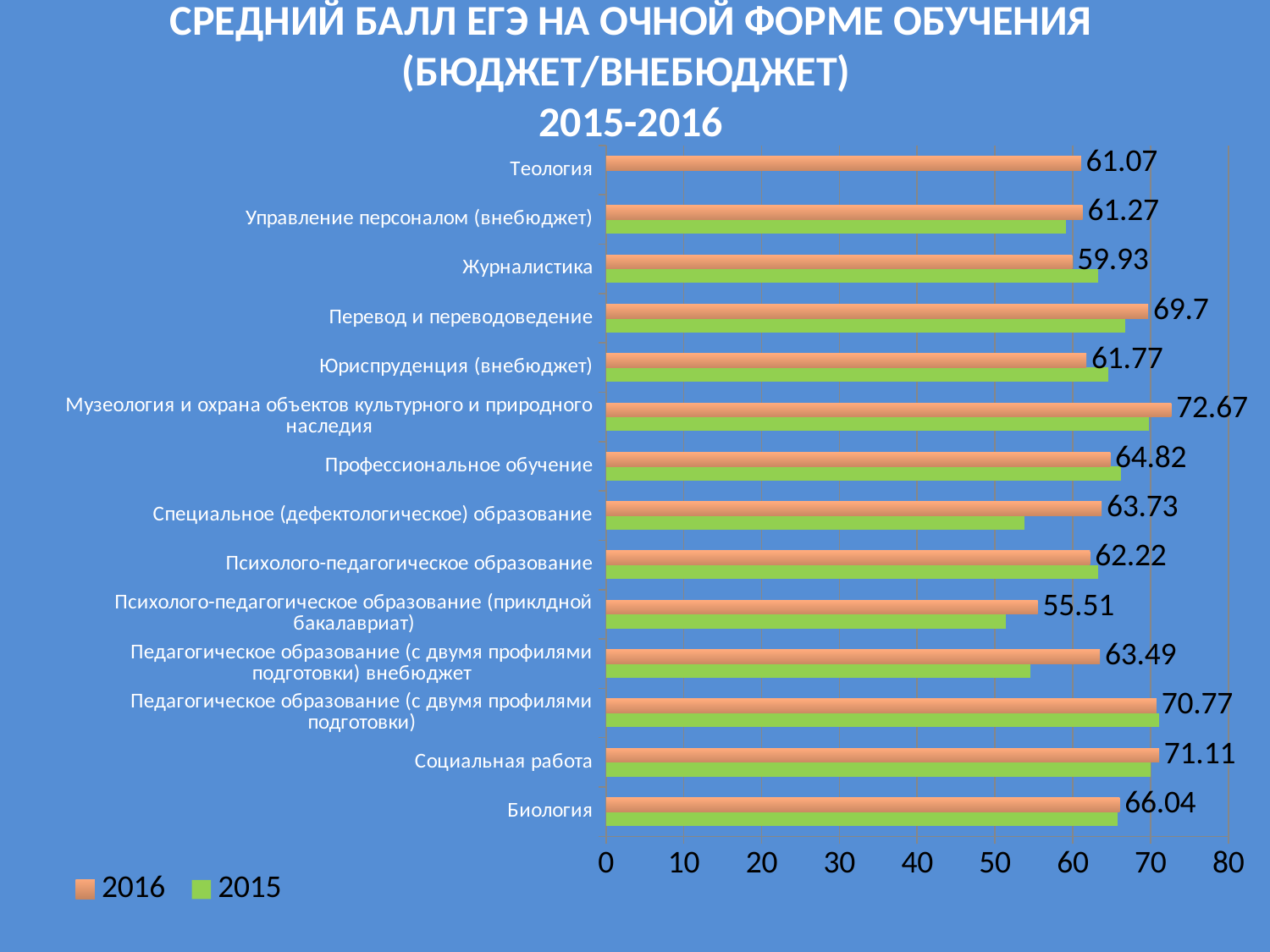
Is the 2015 value for Специальное (дефектологическое) образование greater or less than 60? less How many categories are shown on the chart? 14 Which category has the highest 2016 value? Музеология и охрана объектов культурного и природного наследия Which has the larger 2016 value, Перевод и переводоведение or Юриспруденция (внебюджет)? Перевод и переводоведение What is the difference between the 2016 values for Социальная работа and Биология? 5.07 What is the 2016 value for Журналистика? 59.93 What is the 2016 value for Музеология и охрана объектов культурного и природного наследия? 72.67 What kind of chart is shown on the slide? Bar chart How many series does the legend list? 2 What is the 2016 value for Социальная работа? 71.11 What is the 2016 value for Биология? 66.04 Which category has the lowest 2016 value? Психолого-педагогическое образование (приклдной бакалавриат)